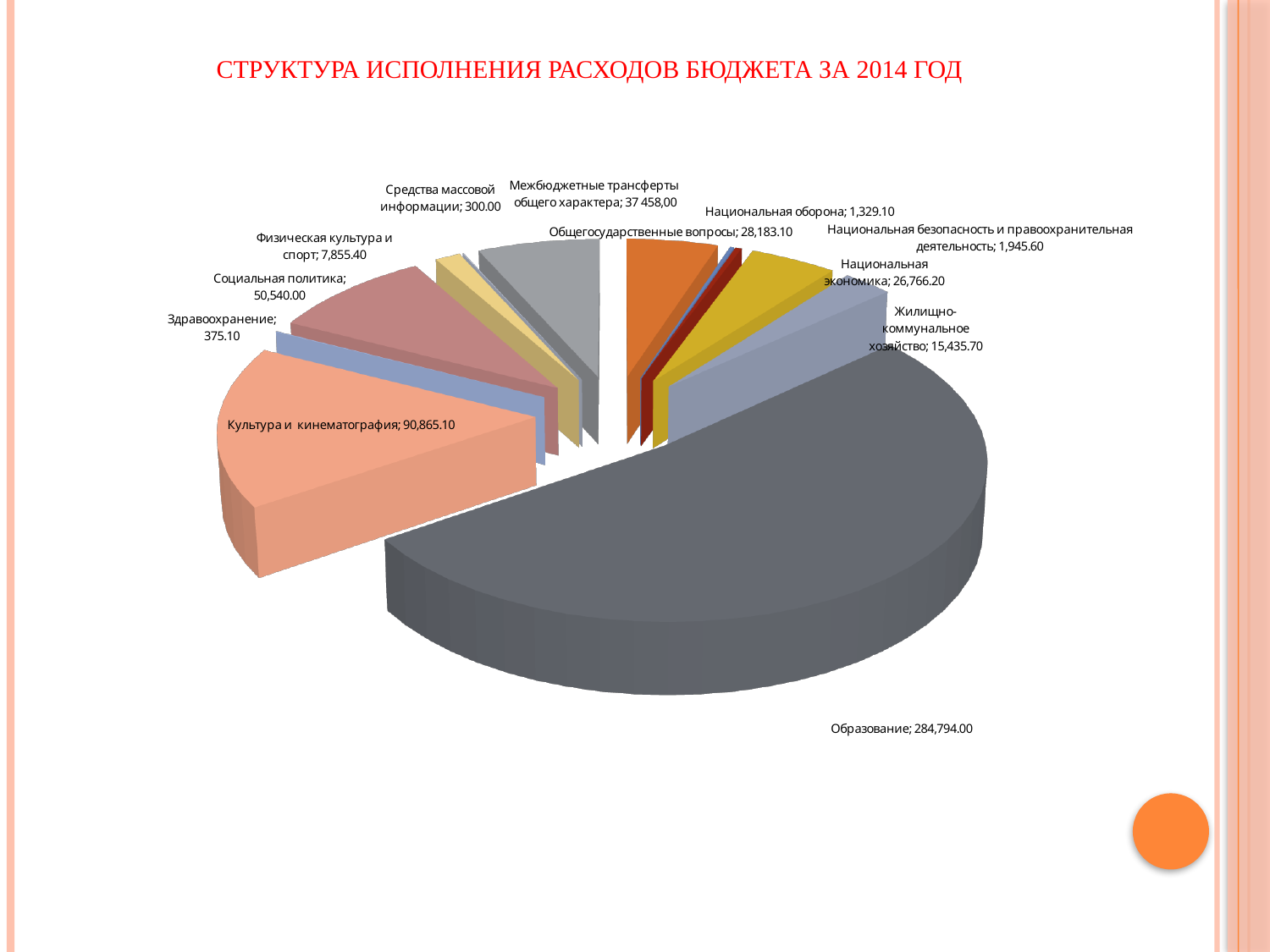
What is the difference between the values for Культура и кинематография and Социальная политика? 40,325.10 Which is larger: Общегосударственные вопросы or Национальная экономика? Общегосударственные вопросы Which category has the smallest value? Средства массовой информации What is the value for Социальная политика? 50,540.00 What is the value for Жилищно-коммунальное хозяйство? 15,435.70 What is the title of the slide? СТРУКТУРА ИСПОЛНЕНИЯ РАСХОДОВ БЮДЖЕТА ЗА 2014 ГОД What kind of chart is shown on the slide? Pie chart How many categories are shown in the pie chart? 12 What is the value for Образование? 284,794.00 What is the value for Культура и кинематография? 90,865.10 What is the value for Здравоохранение? 375.10 Which category has the largest value? Образование